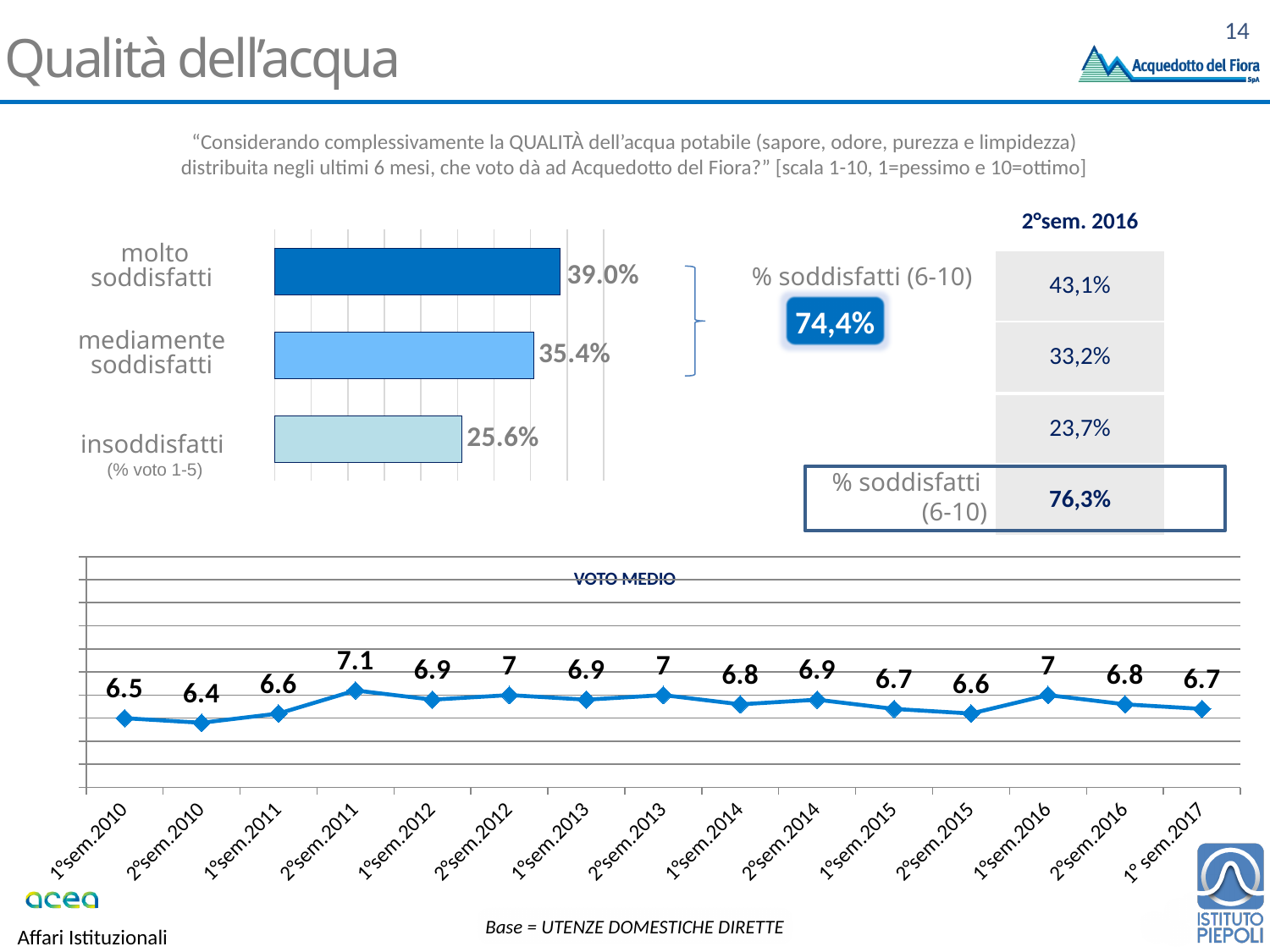
In the "VOTO MEDIO" line chart, which period has the highest value? 2°sem.2011 In the "VOTO MEDIO" line chart, how many data points are plotted? 15 In the "VOTO MEDIO" line chart, which period has the lowest value? 2°sem.2010 In the bar chart at the top of the slide, how many categories are shown? 3 In the bar chart at the top of the slide, what is the value for "insoddisfatti"? 25.6% In the "VOTO MEDIO" line chart, what is the value for 1° sem.2017? 6.7 In the "VOTO MEDIO" line chart, what is the value for 2°sem.2011? 7.1 What kind of chart is the chart at the top of the slide? Bar chart In the bar chart at the top of the slide, which category has the lowest value? insoddisfatti In the "VOTO MEDIO" line chart, which is larger: the value for 1°sem.2016 or the value for 2°sem.2016? 1°sem.2016 In the bar chart at the top of the slide, what is the difference between "molto soddisfatti" and "mediamente soddisfatti"? 3.6 percentage points In the bar chart at the top of the slide, what is the value for "molto soddisfatti"? 39.0%